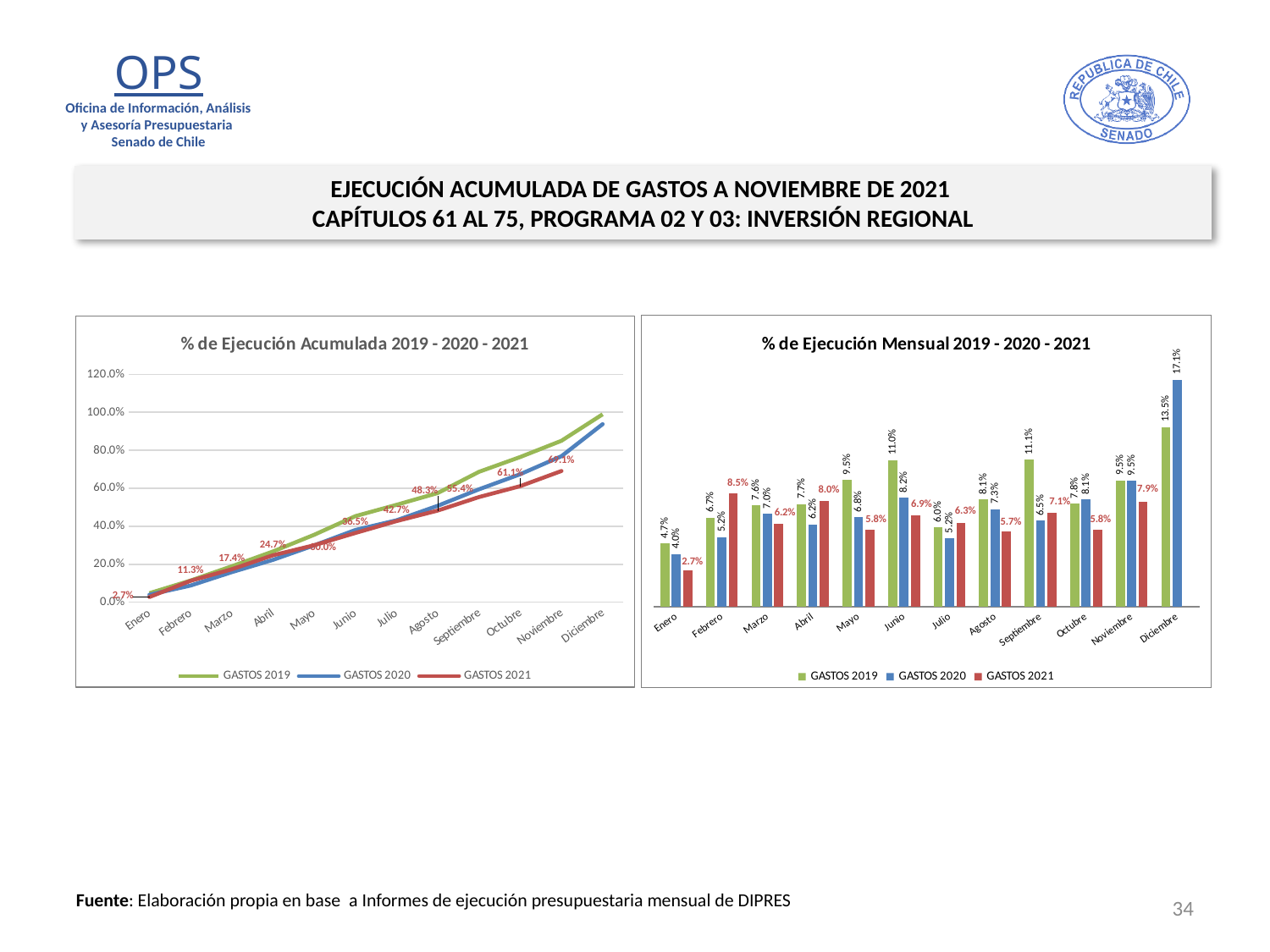
In the left chart '% de Ejecución Acumulada', what is the value for GASTOS 2021 in Noviembre? 69.1% What kind of chart is the right chart titled '% de Ejecución Mensual 2019 - 2020 - 2021'? Bar chart In the right chart '% de Ejecución Mensual', which is larger in Junio: GASTOS 2019 or GASTOS 2021? GASTOS 2019 In the left chart '% de Ejecución Acumulada', is the value for GASTOS 2019 in Diciembre greater or less than 80.0%? greater In the right chart '% de Ejecución Mensual', what is the value for GASTOS 2021 in Febrero? 8.5% In the left chart '% de Ejecución Acumulada', do the GASTOS 2021 values rise or fall from Enero to Noviembre? Rise In the left chart '% de Ejecución Acumulada', what is the value for GASTOS 2021 in Abril? 24.7% What kind of chart is the left chart titled '% de Ejecución Acumulada 2019 - 2020 - 2021'? Line chart In the right chart '% de Ejecución Mensual', what is the difference between GASTOS 2020 and GASTOS 2019 in Diciembre? 3.6 percentage points In the left chart '% de Ejecución Acumulada', how many series does the legend list? 3 In the right chart '% de Ejecución Mensual', which month has the highest value for GASTOS 2020? Diciembre In the right chart '% de Ejecución Mensual', which month has the lowest value for GASTOS 2021? Enero